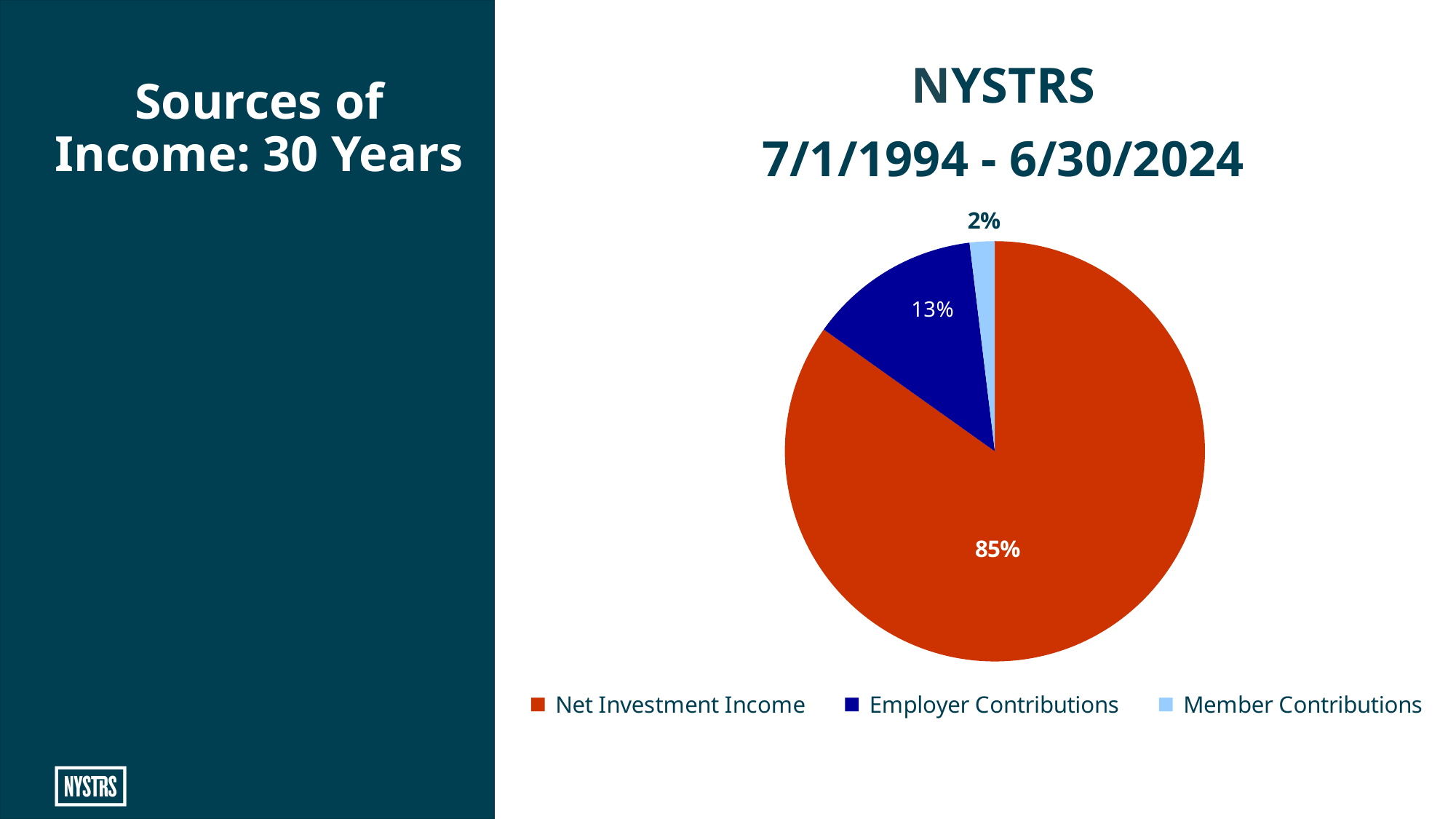
What time period does the chart title cover? 7/1/1994 - 6/30/2024 What share of income does Net Investment Income represent in the pie chart? 85% What share of income does Member Contributions represent? 2% What is the difference in percentage points between Employer Contributions and Member Contributions? 11 What share of income does Employer Contributions represent? 13% What colour is the Employer Contributions slice? Dark blue What kind of chart is shown on the slide? Pie chart What is the difference in percentage points between Net Investment Income and Employer Contributions? 72 How many slices does the pie chart have? 3 Which source of income has the smallest share? Member Contributions Which source of income has the largest share? Net Investment Income Which is larger, Employer Contributions or Member Contributions? Employer Contributions